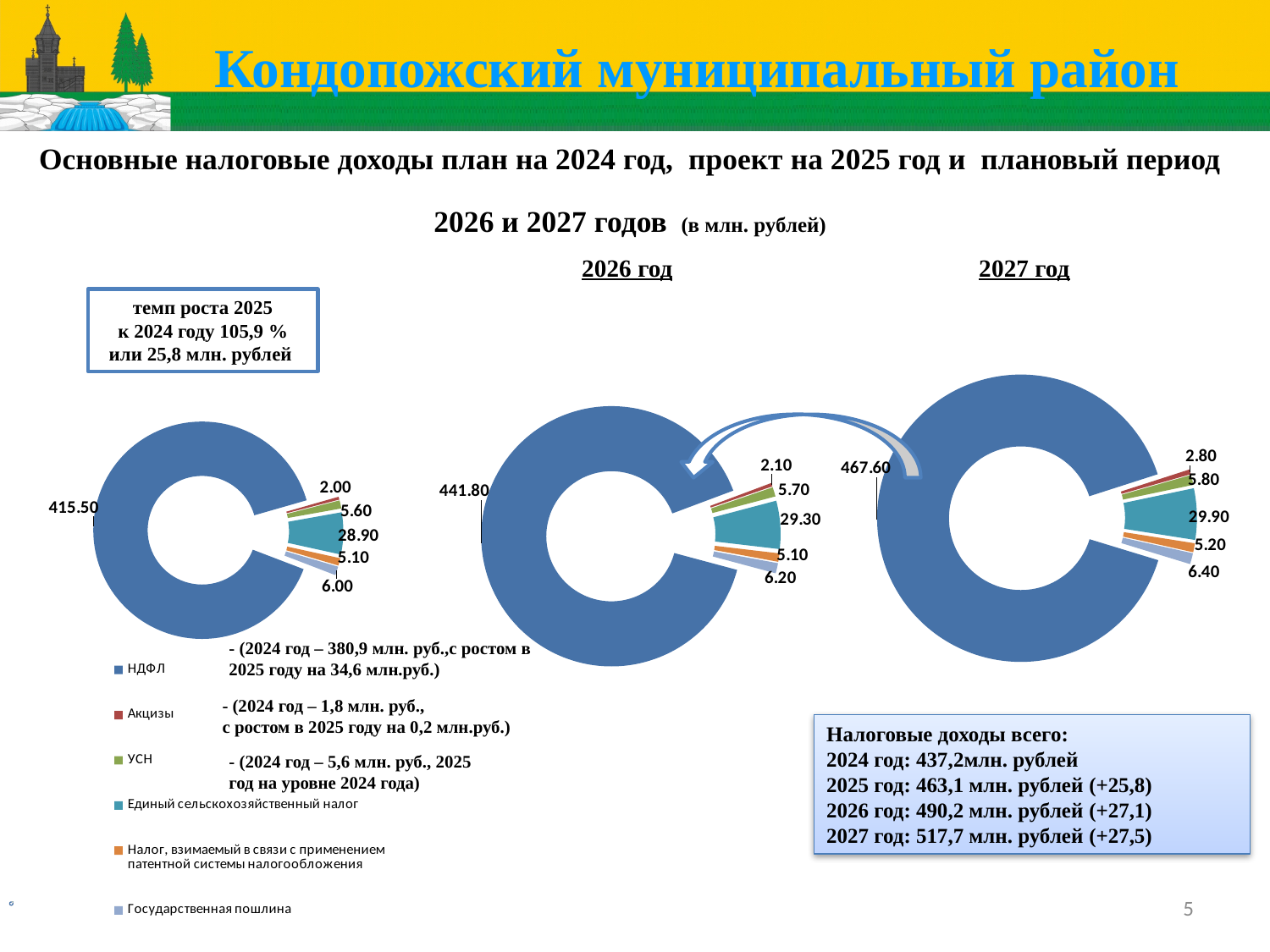
In the chart titled 2027 год, what is the value for Акцизы? 2.80 What colour represents НДФЛ in the charts? Blue Does the value for Единый сельскохозяйственный налог rise or fall from the leftmost chart to the 2026 год chart to the 2027 год chart? Rise In the leftmost chart, what is the value for Государственная пошлина? 6.00 In the chart titled 2027 год, what is the value for Единый сельскохозяйственный налог? 29.90 In the chart titled 2026 год, what is the value for НДФЛ? 441.80 What is the difference between the НДФЛ value in the 2027 год chart and the НДФЛ value in the 2026 год chart? 25.80 In the chart titled 2026 год, which is larger: the value for УСН or the value for Государственная пошлина? Государственная пошлина How many categories does the legend list for the charts? 6 What kind of chart is used to show the 2027 год data? Doughnut chart In the leftmost chart, which category has the smallest value? Акцизы In the chart titled 2026 год, which category has the largest value? НДФЛ